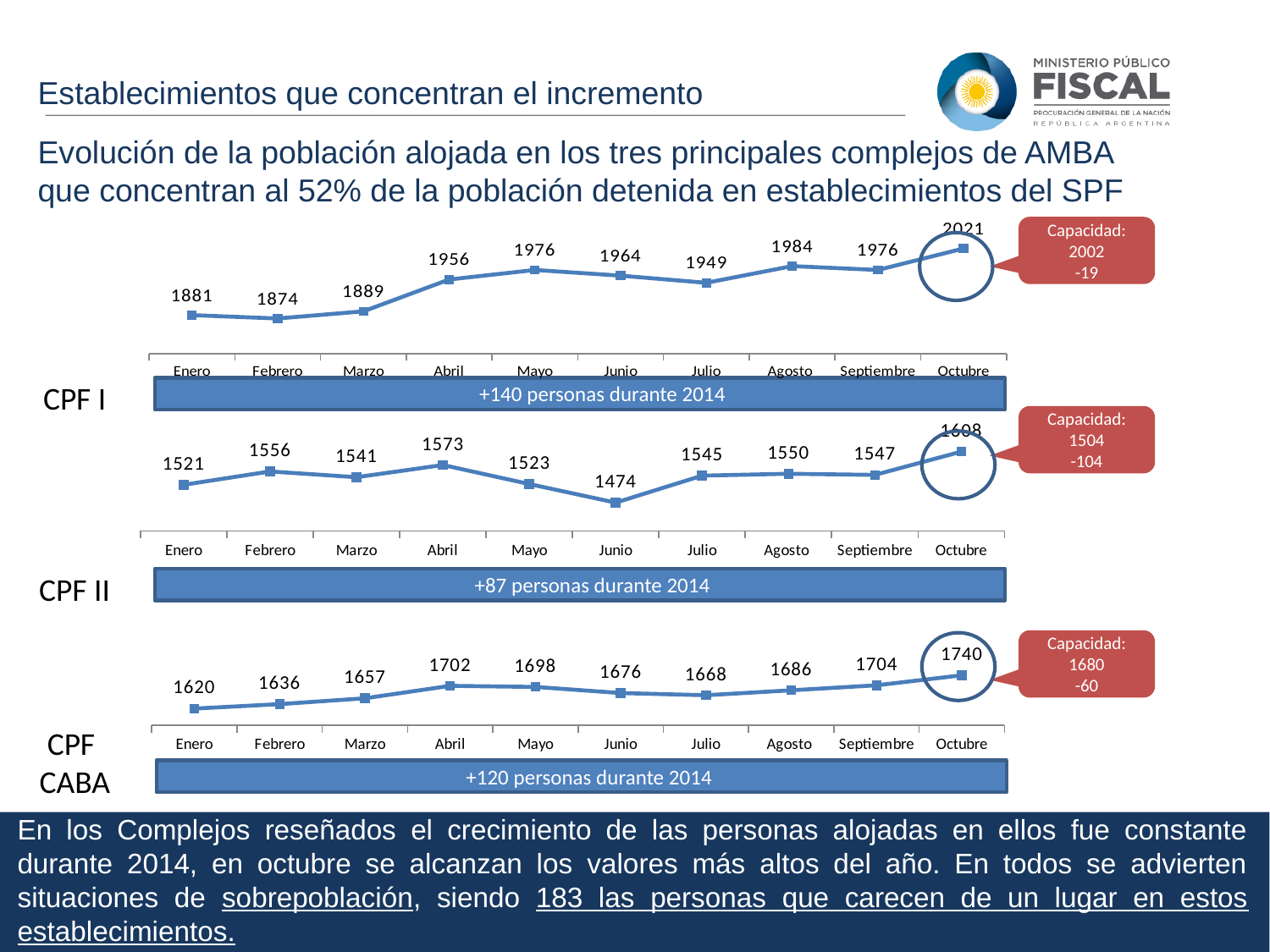
In the CPF II chart, what is the value for Junio? 1474 In the CPF CABA chart, what is the value for Septiembre? 1704 In the CPF II chart, which is larger, the value for Febrero or the value for Marzo? Febrero In the CPF I chart, what is the difference between the Octubre value and the Enero value? 140 How many months are plotted in the CPF II chart? 10 In the CPF I chart, which month has the highest value? Octubre In the CPF I chart, what is the value for Abril? 1956 In the CPF CABA chart, which month has the highest value? Octubre In the CPF I chart, which month has the lowest value? Febrero In the CPF II chart, which month has the lowest value? Junio In the CPF CABA chart, what is the difference between the Abril value and the Enero value? 82 What kind of chart is used for CPF CABA? Line chart